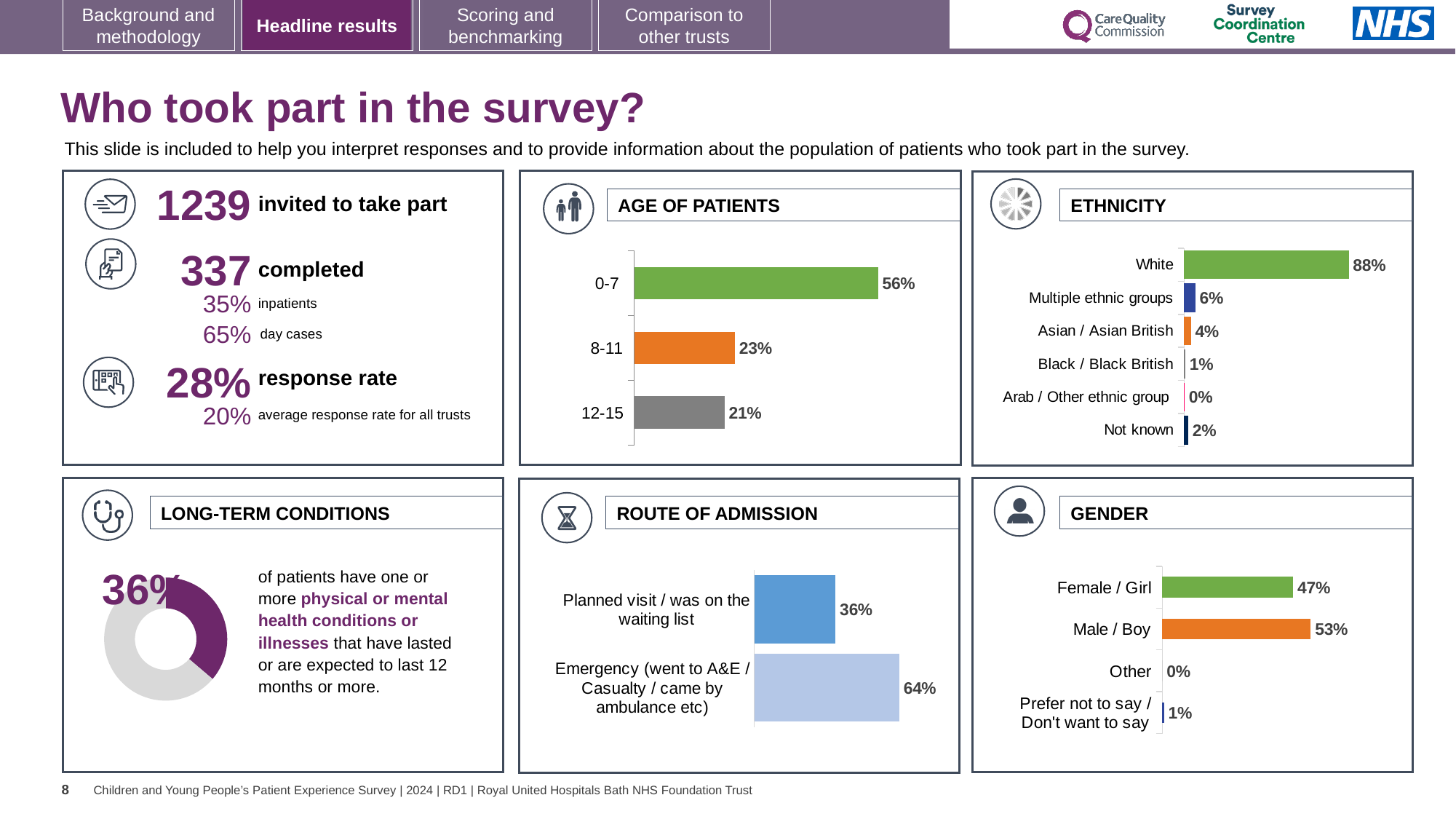
What type of chart is used in the LONG-TERM CONDITIONS panel? Doughnut chart In the ROUTE OF ADMISSION chart, what percentage of patients came via Emergency (went to A&E / Casualty / came by ambulance etc)? 64% In the GENDER chart, which category has the highest percentage? Male / Boy In the AGE OF PATIENTS chart, which age group has the lowest percentage? 12-15 In the ETHNICITY chart, what percentage of patients were White? 88% In the ETHNICITY chart, which is larger: Multiple ethnic groups or Asian / Asian British? Multiple ethnic groups In the ROUTE OF ADMISSION chart, what is the difference between the Emergency and Planned visit percentages? 28% In the ETHNICITY chart, how many ethnicity categories are shown? 6 In the AGE OF PATIENTS chart, what is the difference between the 8-11 and 12-15 percentages? 2% In the LONG-TERM CONDITIONS chart, what percentage of patients have one or more long-term conditions? 36% In the GENDER chart, what percentage of patients were Male / Boy? 53% In the AGE OF PATIENTS chart, what percentage of patients were aged 0-7? 56%